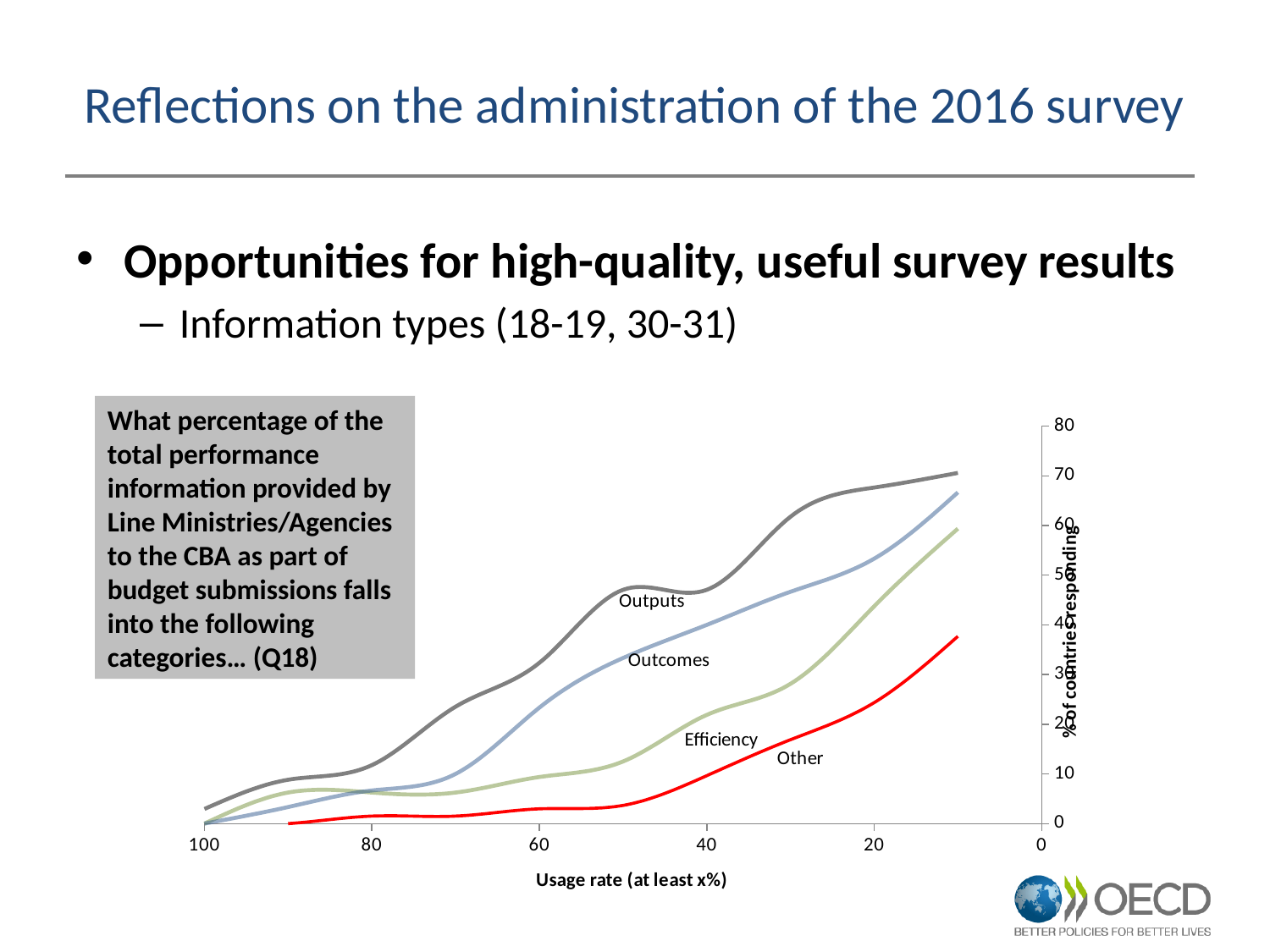
Do the values of the series rise or fall as the usage rate decreases from 100 to 0 along the x axis? rise Is the value for Outcomes at a usage rate of 10 greater or less than 60? greater At a usage rate of 60, which series is higher: Outcomes or Efficiency? Outcomes Is the value for Outputs at a usage rate of 50 greater or less than 40? greater Which series has the lowest values across the chart? Other How many series are plotted on the chart? 4 What kind of chart is shown on the slide? Line chart What is the title of the x axis? Usage rate (at least x%) What is the title of the y axis? % of countries responding At a usage rate of 40, which series is higher: Outputs or Outcomes? Outputs Which series has the highest values across the chart? Outputs